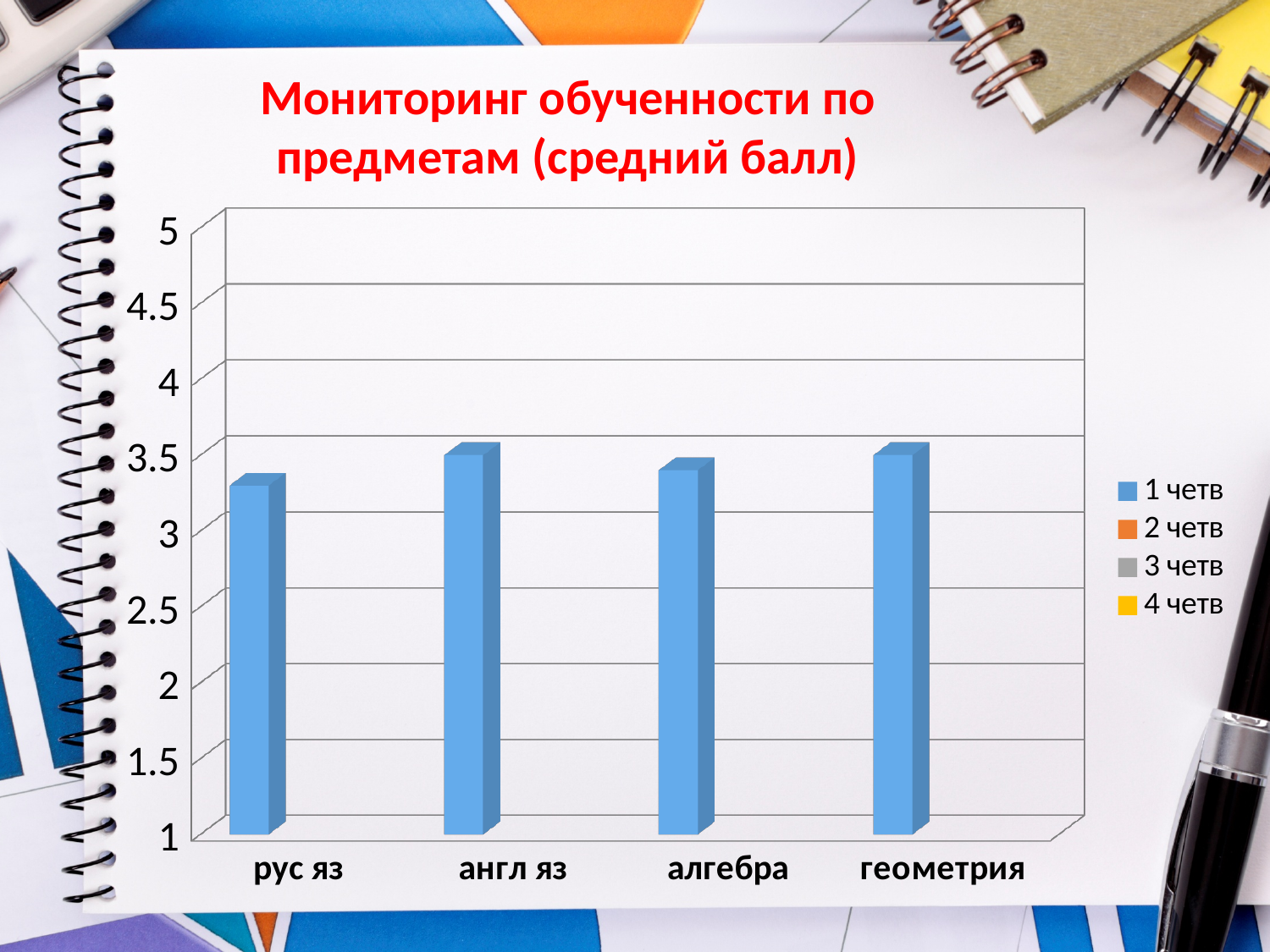
Is the value for рус яз greater or less than 3? greater What is the title of the chart? Мониторинг обученности по предметам (средний балл) Is the value for рус яз greater or less than 3.5? less Which is larger, the value for англ яз or the value for рус яз? англ яз How many series does the legend list? 4 Which legend entry is shown in blue? 1 четв Is the value for алгебра greater or less than 3? greater Which is larger, the value for геометрия or the value for рус яз? геометрия What kind of chart is shown on the slide? bar chart Which subject has the lowest average score? рус яз How many subjects (categories) are shown on the x axis? 4